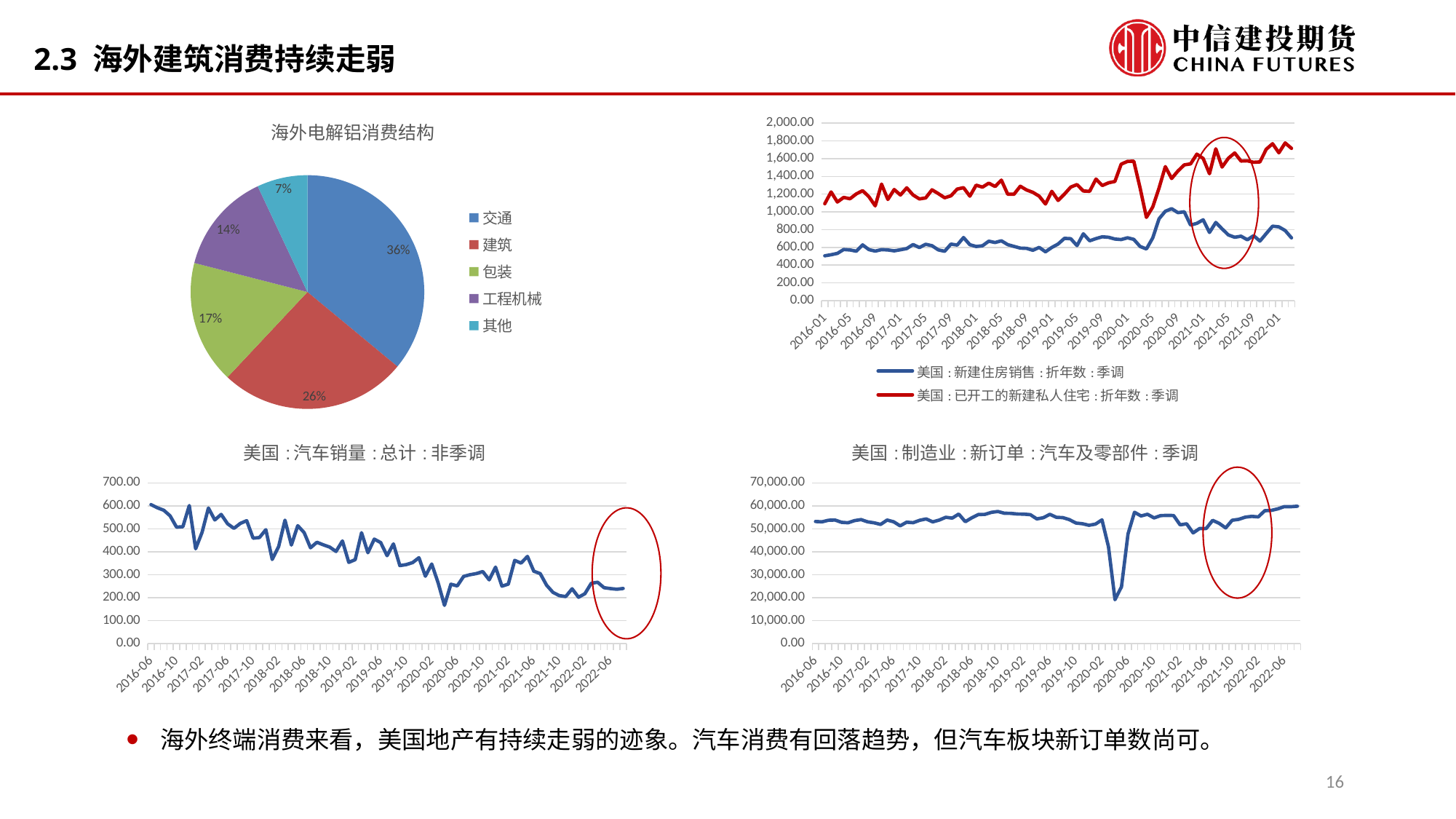
In the pie chart titled 海外电解铝消费结构, what share does 交通 account for? 36% How many series does the legend of the top-right line chart list? 2 What type of chart is the top-left chart titled 海外电解铝消费结构? Pie chart In the pie chart titled 海外电解铝消费结构, what is the difference in percentage points between the shares of 交通 and 建筑? 10 percentage points In the chart titled 美国:制造业:新订单:汽车及零部件:季调, is the value at 2020-06 greater or less than 30,000.00? greater In the top-right line chart, which series is drawn in red? 美国:已开工的新建私人住宅:折年数:季调 In the pie chart titled 海外电解铝消费结构, what share does 建筑 account for? 26% In the pie chart titled 海外电解铝消费结构, which has a larger share, 包装 or 工程机械? 包装 How many categories does the pie chart titled 海外电解铝消费结构 show? 5 In the pie chart titled 海外电解铝消费结构, which category has the largest share? 交通 In the pie chart titled 海外电解铝消费结构, which category has the smallest share? 其他 In the chart titled 美国:汽车销量:总计:非季调, is the value at 2022-06 greater or less than 300.00? less